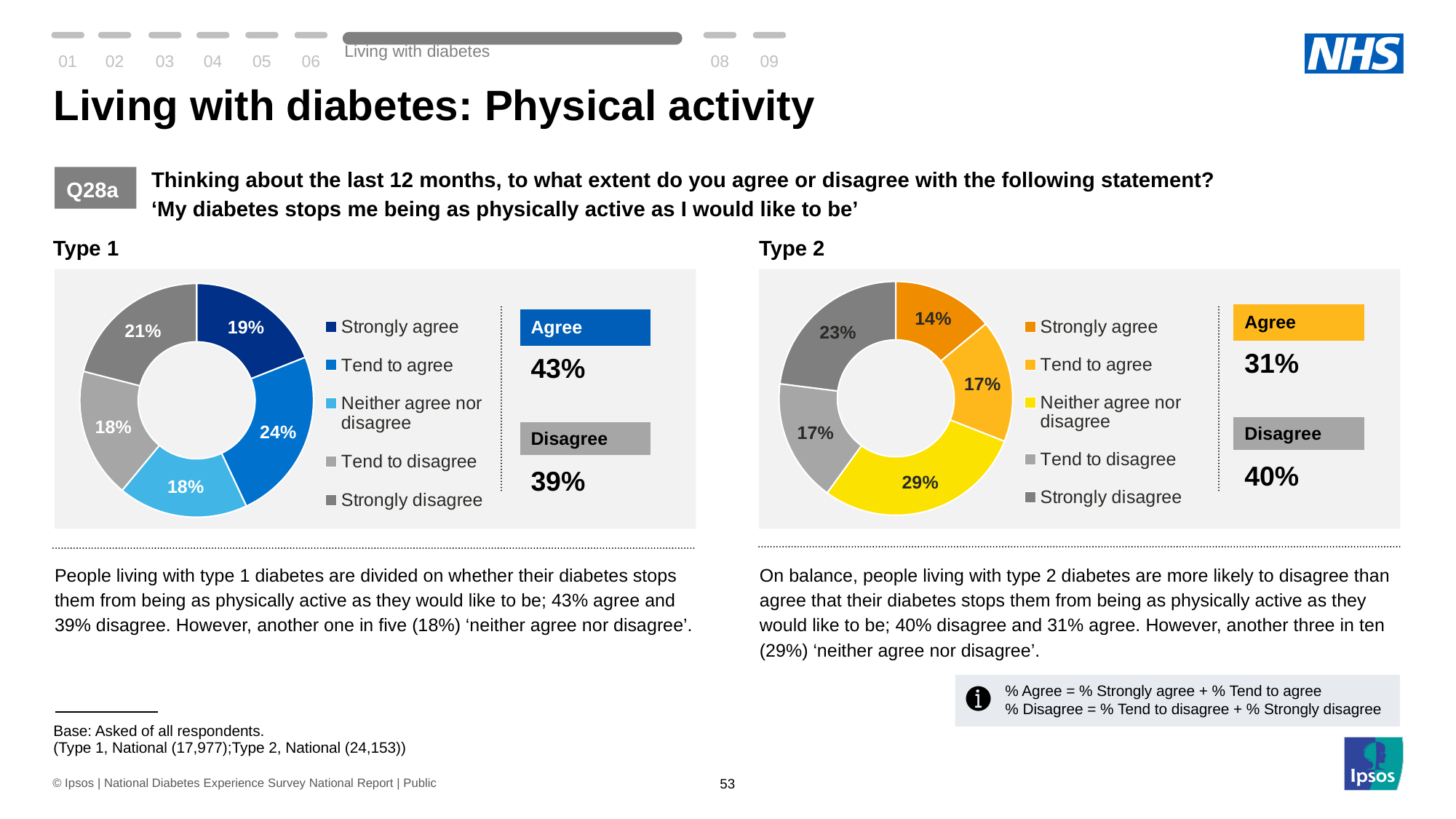
In the Type 2 chart, which is larger: 'Strongly disagree' or 'Tend to disagree'? Strongly disagree In the Type 2 chart, what percentage of respondents 'Strongly agree'? 14% How many categories does the legend of the Type 1 chart list? 5 In the Type 2 chart, which category has the smallest share? Strongly agree What kind of chart is used for Type 1 and Type 2? Donut (pie) chart In the Type 1 chart, what is the difference between the 'Tend to agree' and 'Strongly agree' percentages? 5% In the Type 1 chart, which category has the largest share? Tend to agree In the Type 2 chart, which category has the largest share? Neither agree nor disagree What is the combined 'Disagree' percentage shown for the Type 2 chart? 40% In the Type 1 chart, what percentage of respondents 'Strongly disagree'? 21% In the Type 1 chart, what percentage of respondents 'Tend to agree'? 24% In the Type 2 chart, what percentage of respondents 'Neither agree nor disagree'? 29%